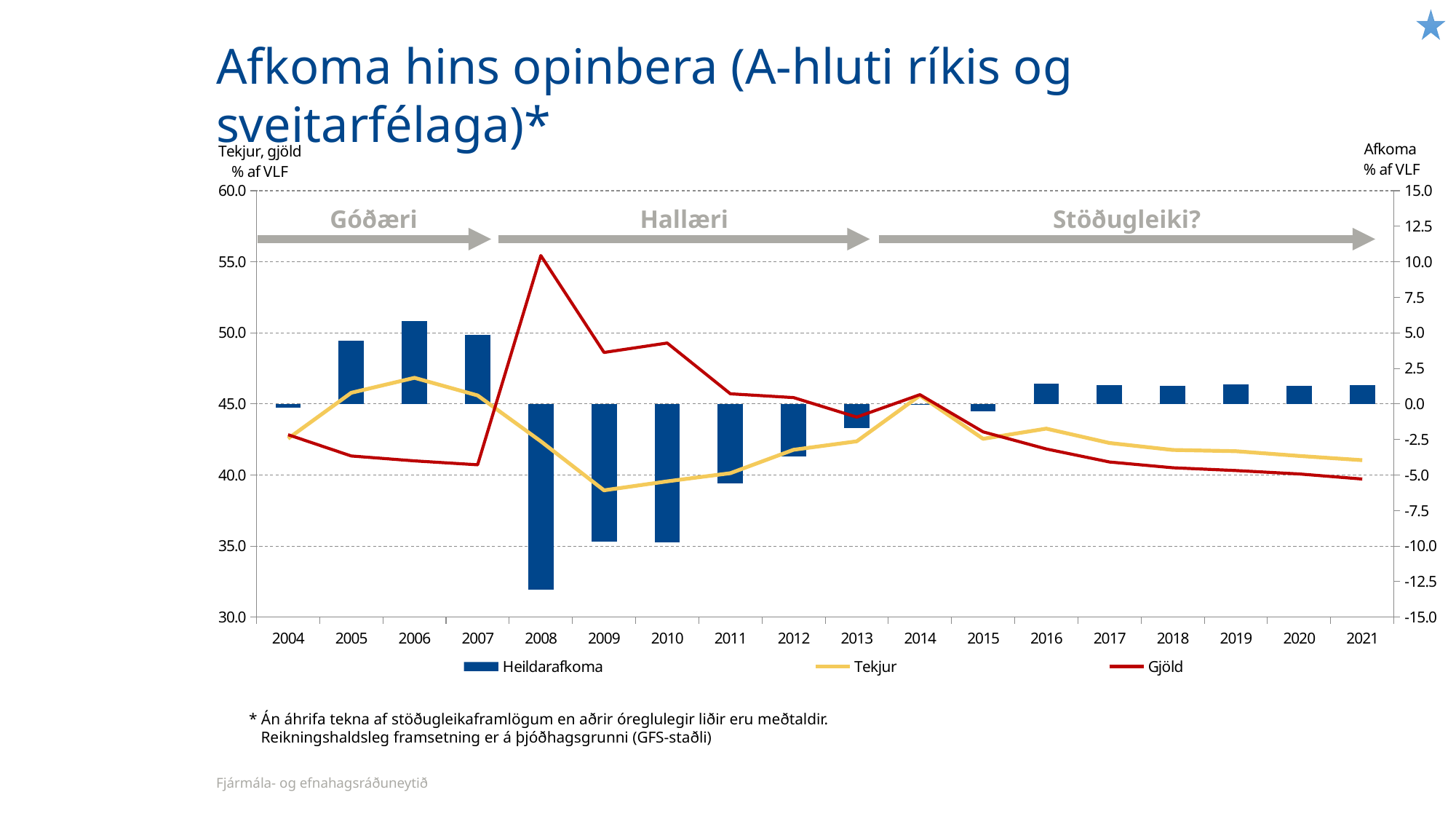
Does the Gjöld line rise or fall from 2008 to 2013? Fall In 2008, which is larger, Tekjur or Gjöld? Gjöld Is the Heildarafkoma value for 2008 greater or less than -10.0 on the right axis? less Is the Tekjur value for 2006 greater or less than 45.0 on the left axis? greater How many years are shown on the x axis? 18 Is the Gjöld value for 2008 greater or less than 50.0 on the left axis? greater In which year does the Gjöld line reach its highest point? 2008 In which year is the Heildarafkoma bar lowest? 2008 What are the three series named in the legend? Heildarafkoma, Tekjur, Gjöld How many series does the legend list? 3 In which year is the Heildarafkoma bar highest? 2006 What kind of chart is shown on the slide? A combination chart with bars and lines